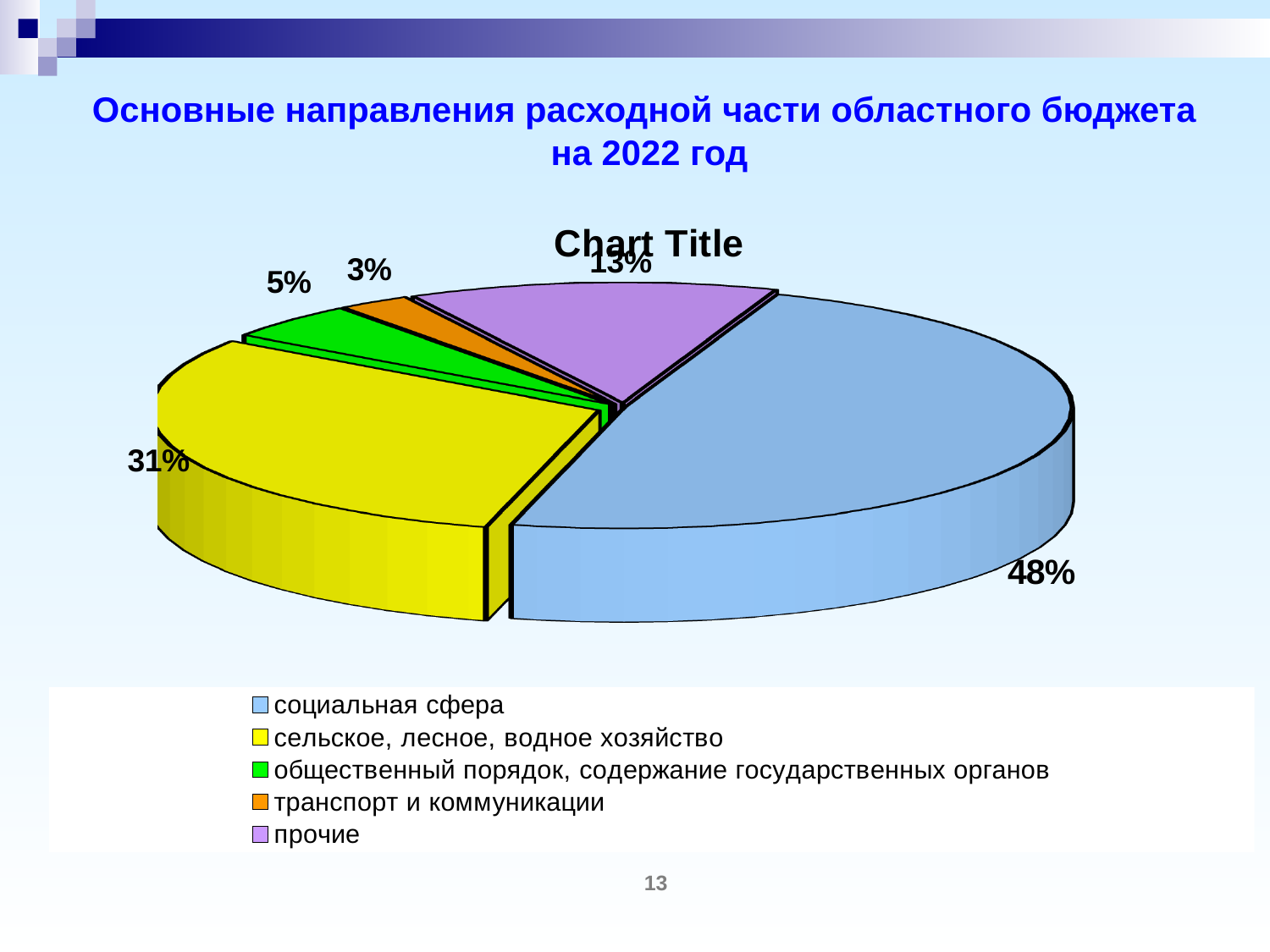
What is the difference in percentage points between "социальная сфера" and "сельское, лесное, водное хозяйство"? 17 What share of the pie does "общественный порядок, содержание государственных органов" take? 5% Which category has the largest slice of the pie? социальная сфера What share of the pie does "транспорт и коммуникации" take? 3% What kind of chart is shown on the slide? pie chart Which category has the smallest slice of the pie? транспорт и коммуникации How many categories does the legend list? 5 What share of the pie does "прочие" take? 13% Which is larger: the slice for "прочие" or the slice for "общественный порядок, содержание государственных органов"? прочие What colour is the slice for "сельское, лесное, водное хозяйство"? yellow